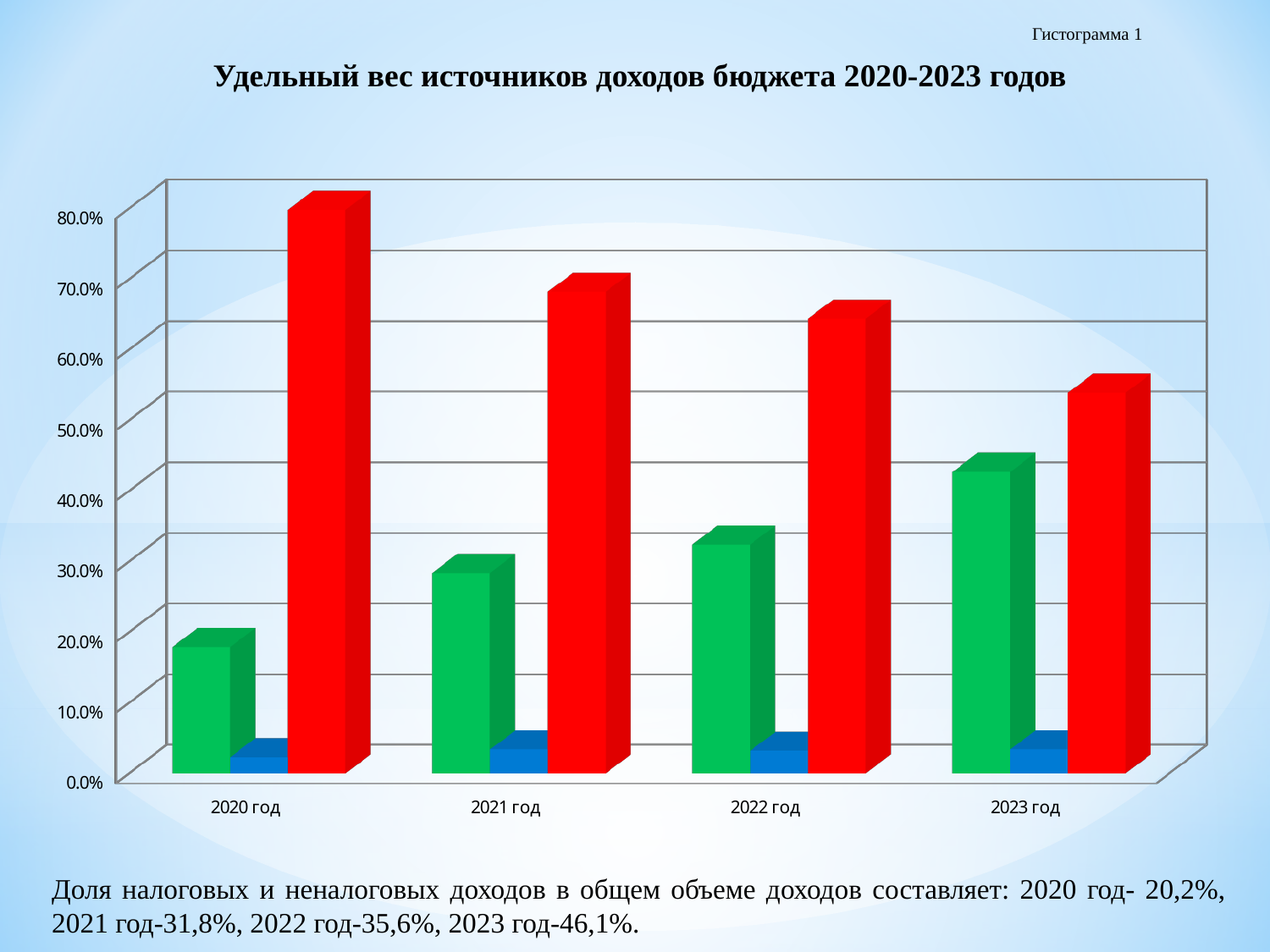
Do the green bars rise or fall from 2020 год to 2023 год? rise What is the title of the chart? Удельный вес источников доходов бюджета 2020-2023 годов Which is larger, the green bar for 2020 год or the green bar for 2023 год? 2023 год Is the blue bar for 2021 год greater or less than 10.0%? less Is the green bar for 2023 год greater or less than 40.0%? greater How many year categories are shown on the x axis? 4 Is the red bar for 2023 год greater or less than 60.0%? less What kind of chart is shown on the slide? bar chart Which year has the tallest red bar? 2020 год How many bars are plotted for each year? 3 Do the red bars rise or fall from 2020 год to 2023 год? fall